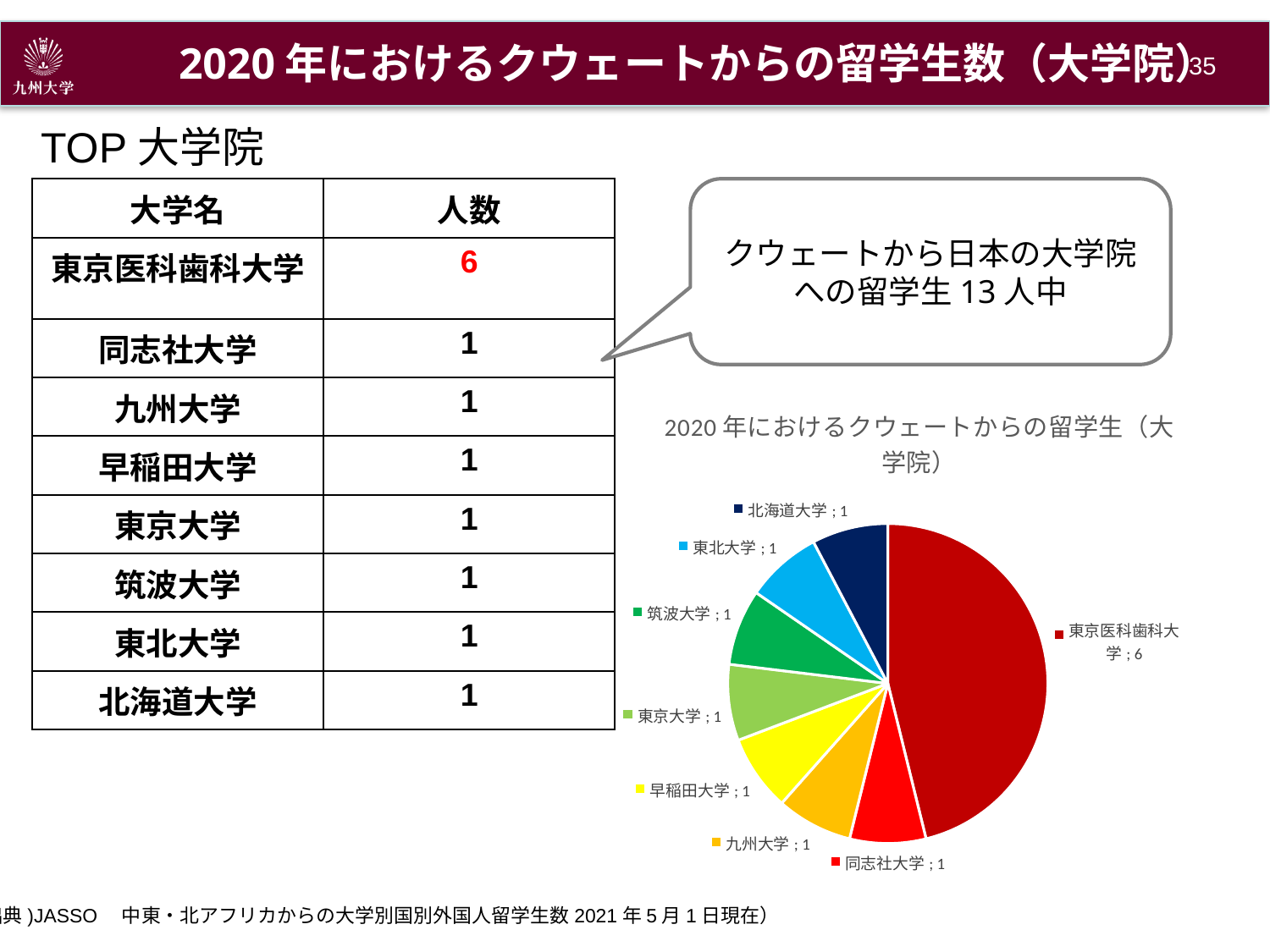
What is the total of all slices in the pie chart? 13 What share of the pie does 東京医科歯科大学 represent? 6/13 What kind of chart is shown on the slide? pie chart Which university has the largest slice in the pie chart? 東京医科歯科大学 What is the value for 九州大学 in the pie chart? 1 How many slices does the pie chart have? 8 What colour is the slice for 東京医科歯科大学 in the pie chart? dark red What is the title of the pie chart? 2020年におけるクウェートからの留学生（大学院） What is the value for 東京医科歯科大学 in the pie chart? 6 What is the value for 北海道大学 in the pie chart? 1 Which is larger in the pie chart, the value for 東京医科歯科大学 or the value for 早稲田大学? 東京医科歯科大学 What is the difference between the values for 東京医科歯科大学 and 同志社大学 in the pie chart? 5